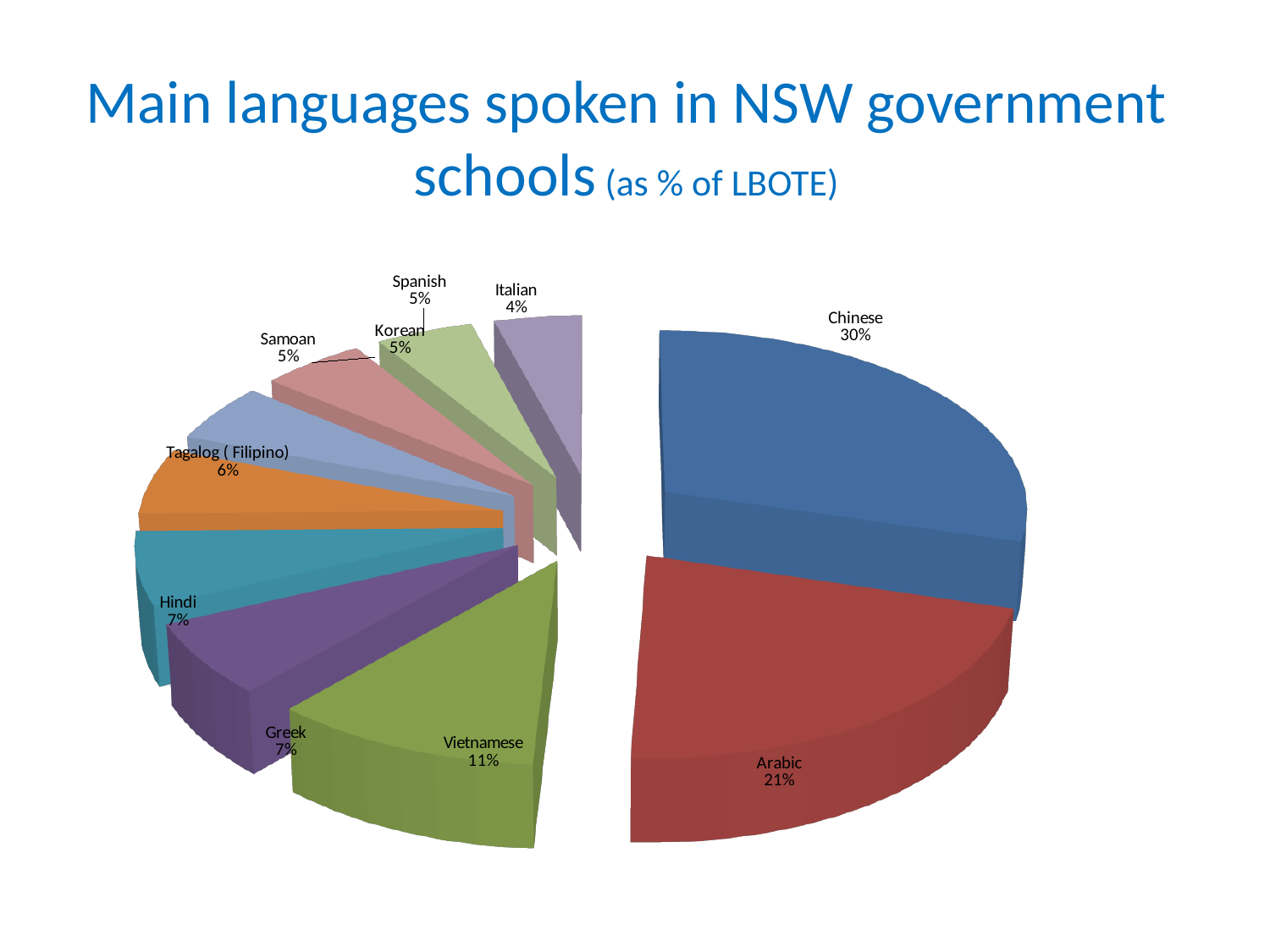
What is the difference in percentage points between Vietnamese and Greek? 4 Which has a larger share, Hindi or Italian? Hindi What percentage is shown for Vietnamese? 11% What percentage of LBOTE students speak Chinese? 30% What type of chart is shown on the slide? Pie chart What is the title of the chart on the slide? Main languages spoken in NSW government schools (as % of LBOTE) What is the difference in percentage points between Chinese and Arabic? 9 What percentage is shown for Arabic? 21% Which language has the largest share of the pie? Chinese Which language has the smallest share of the pie? Italian How many languages are shown in the pie chart? 10 What percentage is shown for Tagalog (Filipino)? 6%